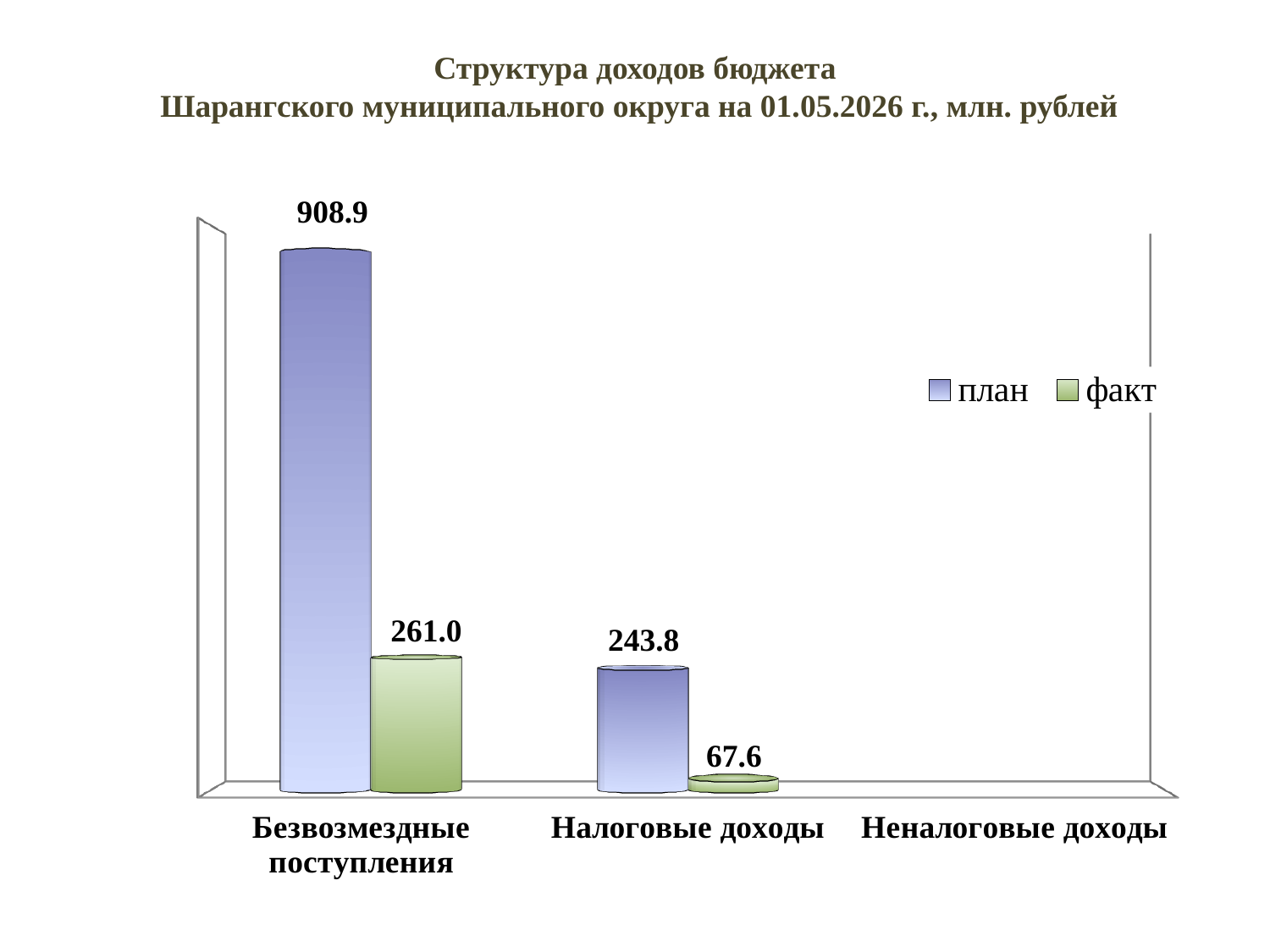
How many categories are shown on the x axis? 3 What is the факт value for Безвозмездные поступления? 261.0 Which labelled факт value is the lowest? Налоговые доходы What is the план value for Безвозмездные поступления? 908.9 What kind of chart is shown on the slide? bar chart Which is larger: the факт value for Безвозмездные поступления or the план value for Налоговые доходы? факт value for Безвозмездные поступления Which category has the highest план value? Безвозмездные поступления What is the факт value for Налоговые доходы? 67.6 What is the difference between the план and факт values for Налоговые доходы? 176.2 What is the difference between the план and факт values for Безвозмездные поступления? 647.9 What is the план value for Налоговые доходы? 243.8 How many series does the legend list? 2